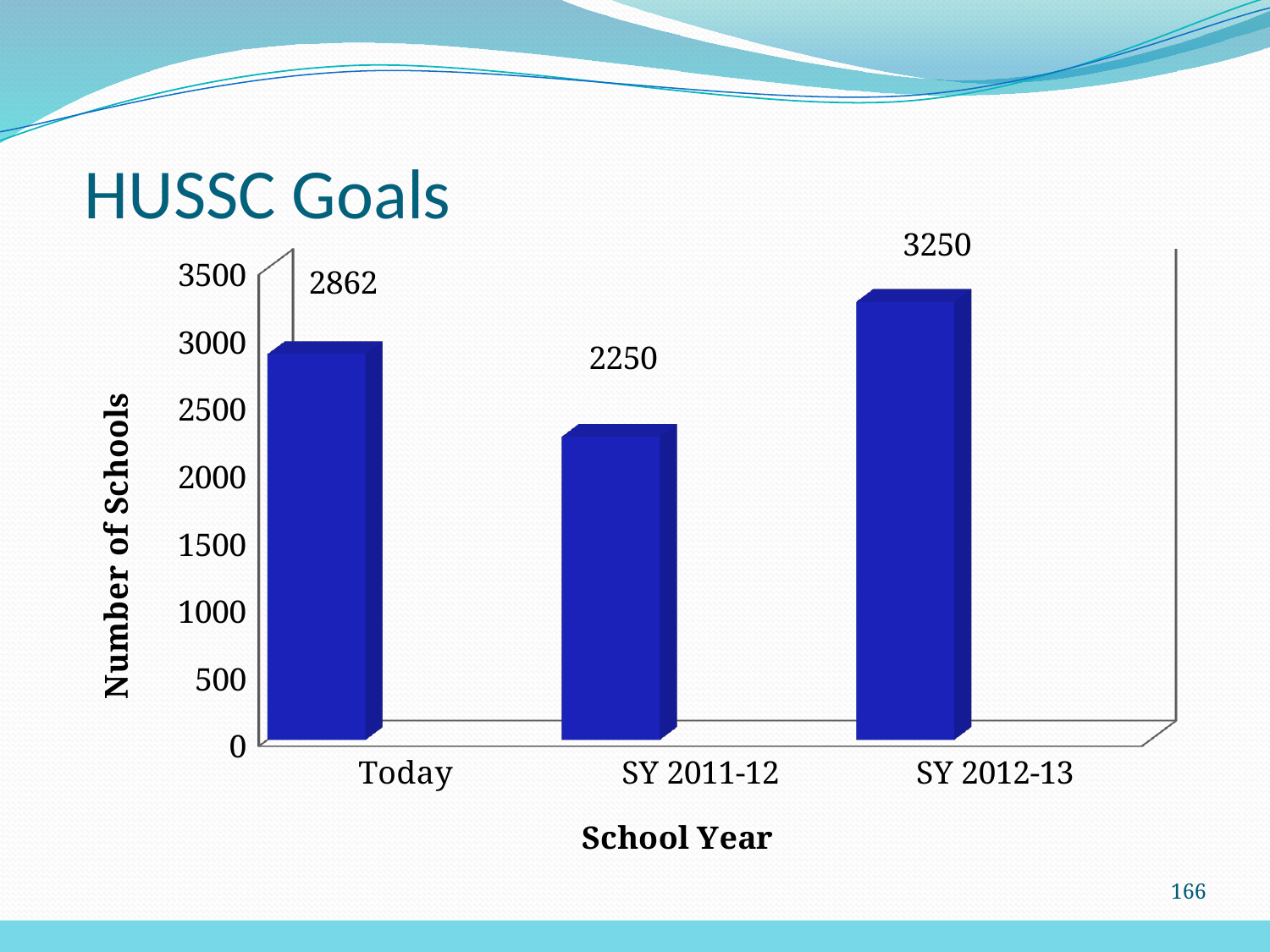
What is the number of schools for SY 2012-13? 3250 What is the difference in number of schools between Today and SY 2011-12? 612 What is the number of schools for Today? 2862 What kind of chart is shown on the slide? bar chart Which school year has the lowest number of schools? SY 2011-12 Which is larger, the number of schools for Today or for SY 2012-13? SY 2012-13 What is the difference in number of schools between SY 2012-13 and SY 2011-12? 1000 Is the number of schools for Today greater or less than 2500? greater What is the label of the y axis? Number of Schools What is the number of schools for SY 2011-12? 2250 How many categories are shown on the x axis? 3 Which school year has the highest number of schools? SY 2012-13